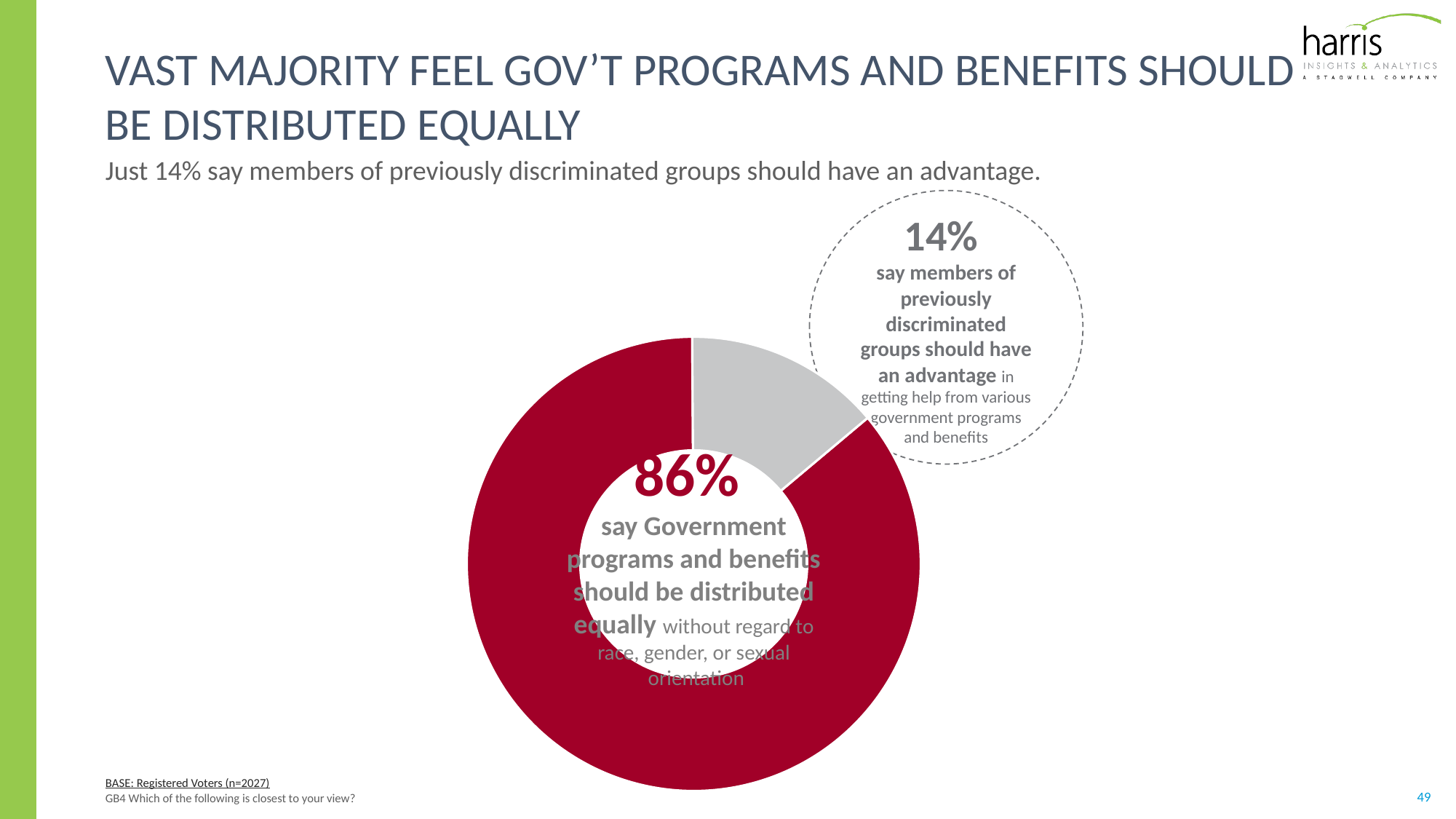
How many segments does the chart have? 2 What share of the pie does the 'distributed equally' segment represent? 86% What is the total of the two segments shown in the chart? 100% What colour is the segment representing those who say benefits should be distributed equally? Red What is the difference in percentage points between the 'distributed equally' share and the 'advantage' share? 72 What percentage say members of previously discriminated groups should have an advantage? 14% What kind of chart is shown on the slide? Pie (donut) chart Is the share saying previously discriminated groups should have an advantage larger or smaller than the share saying benefits should be distributed equally? Smaller What percentage say Government programs and benefits should be distributed equally? 86% Which response has the larger share: distributed equally or advantage for previously discriminated groups? Distributed equally What colour is the segment representing those who say previously discriminated groups should have an advantage? Grey Which response has the smaller share of the chart? Advantage for previously discriminated groups